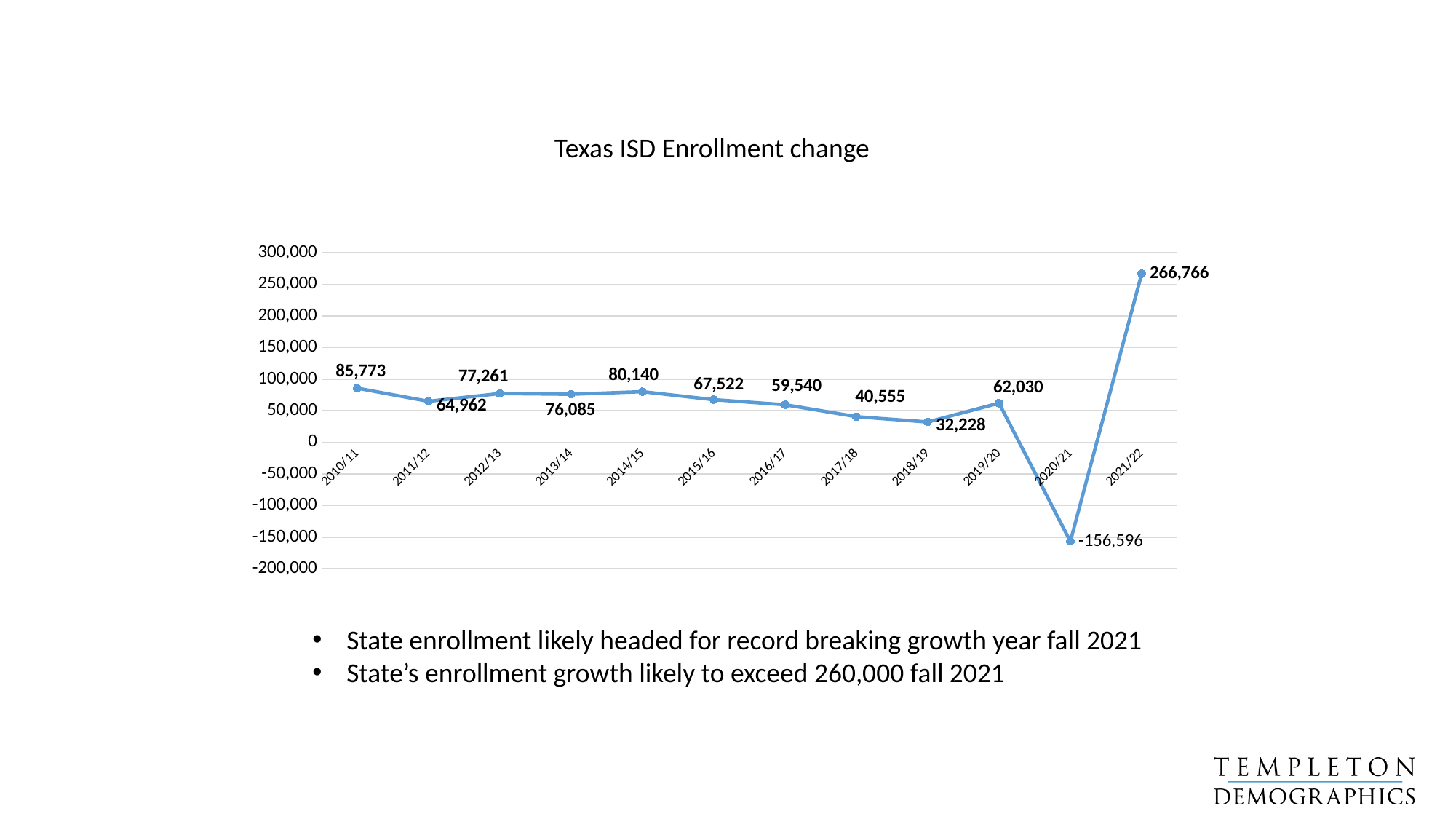
Which school year has the highest enrollment change? 2021/22 What is the title of the chart? Texas ISD Enrollment change How many school years are plotted on the chart? 12 What is the difference between the enrollment change in 2010/11 and in 2011/12? 20,811 Which is larger, the enrollment change for 2014/15 or for 2013/14? 2014/15 Which school year has the lowest enrollment change? 2020/21 Does the enrollment change rise or fall from 2014/15 to 2018/19? Fall What is the enrollment change value for 2018/19? 32,228 What kind of chart is shown on the slide? Line chart What is the enrollment change value for 2020/21? -156,596 What is the difference between the enrollment change in 2021/22 and in 2020/21? 423,362 What is the enrollment change value for 2010/11? 85,773